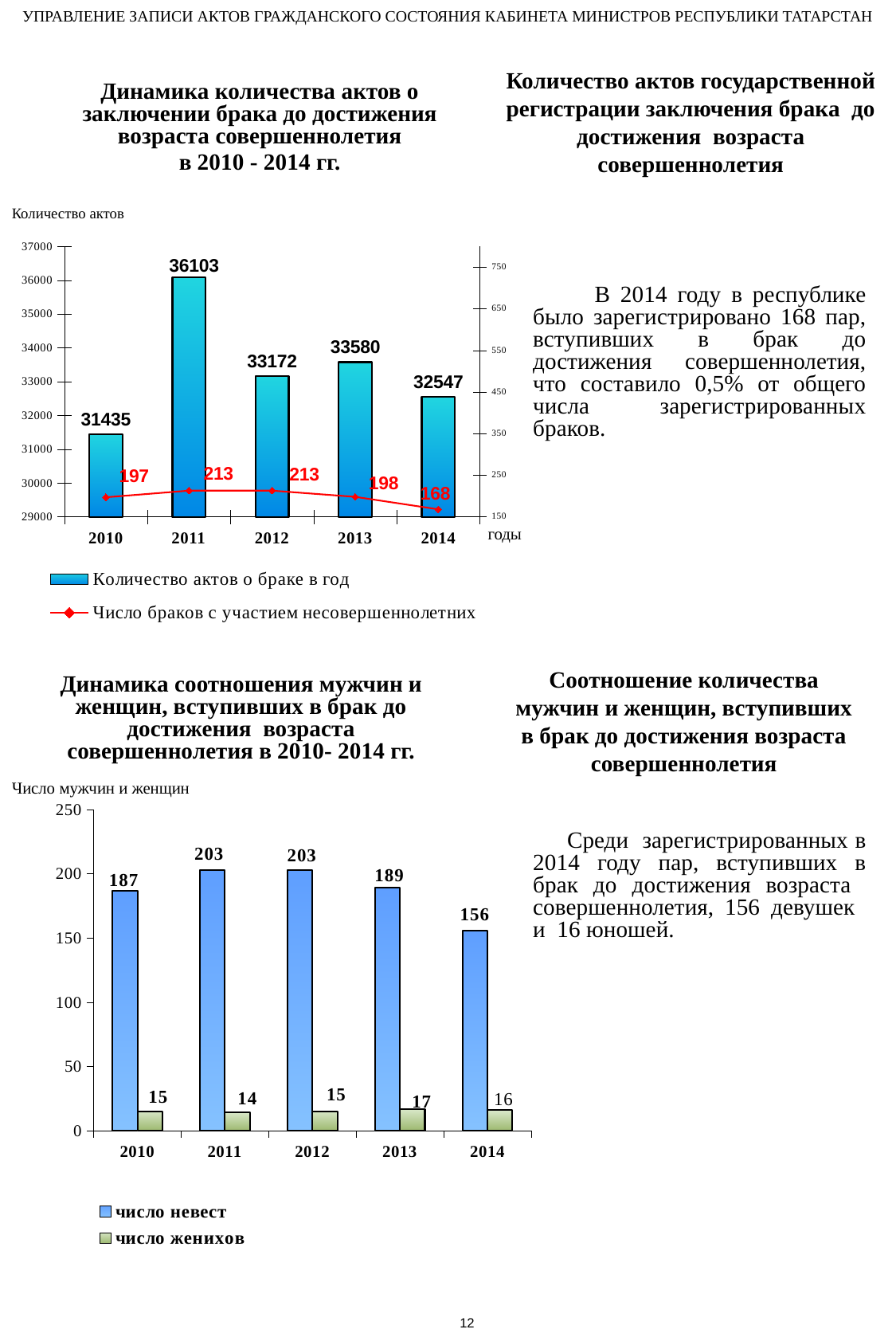
What type of chart is the bottom chart? bar chart In the top chart, does the 'Число браков с участием несовершеннолетних' line rise or fall from 2013 to 2014? fall In the top chart, what is the value of 'Количество актов о браке в год' for 2011? 36103 In the top chart, what is the value of 'Число браков с участием несовершеннолетних' for 2014? 168 In the bottom chart, which year has the lowest value of 'число невест'? 2014 In the bottom chart, what is the difference between 'число невест' and 'число женихов' in 2014? 140 In the bottom chart, how many years are shown on the x axis? 5 In the top chart, which year has the lowest value of 'Количество актов о браке в год'? 2010 In the top chart, what is the difference between the 'Количество актов о браке в год' values for 2011 and 2010? 4668 In the bottom chart, what is the value of 'число женихов' for 2011? 14 In the top chart, how many series does the legend list? 2 In the bottom chart, what is the value of 'число невест' for 2013? 189